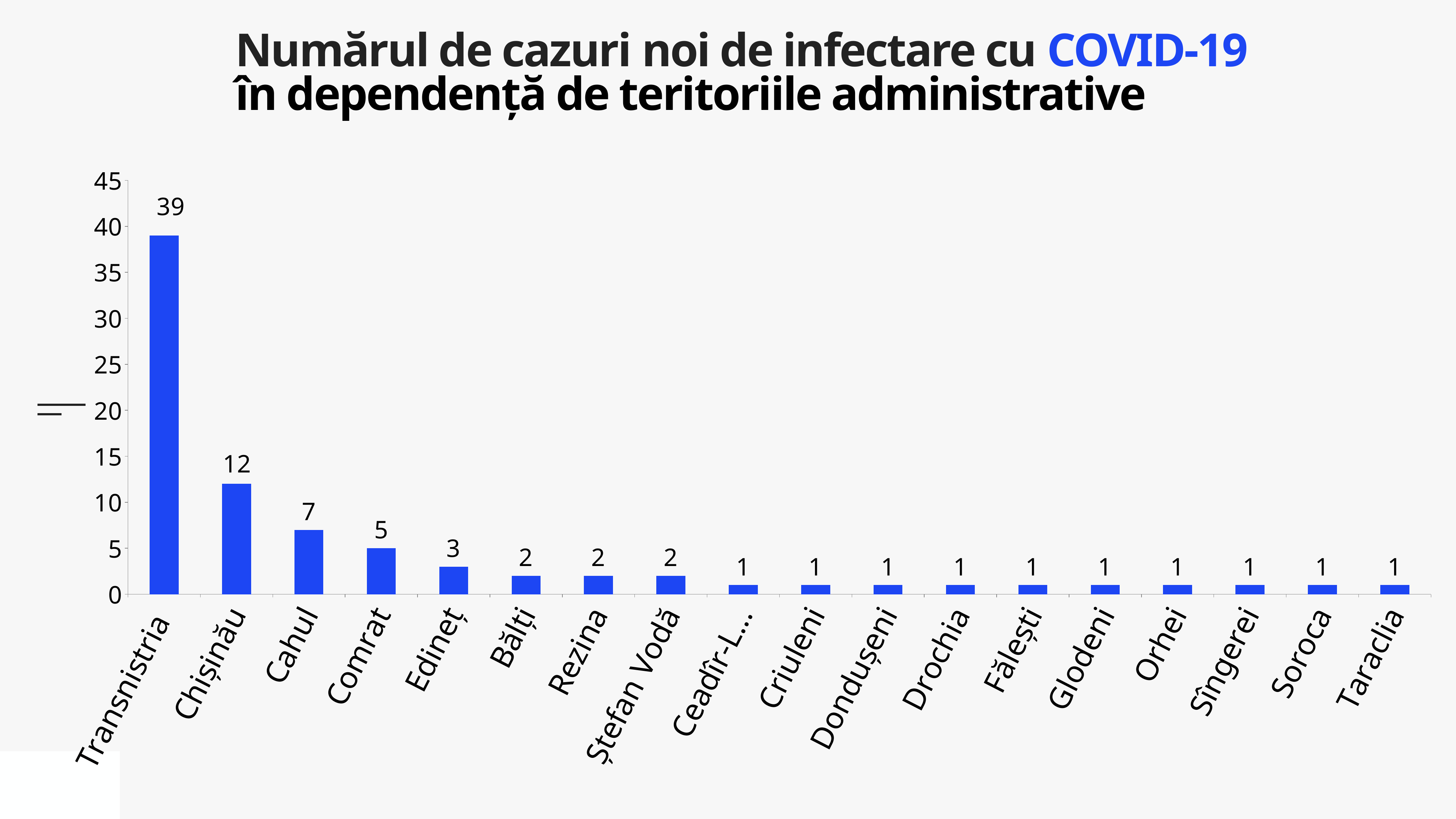
Which territory has the highest number of new cases? Transnistria Which is larger, the value for Comrat or the value for Edineț? Comrat What is the value for Transnistria? 39 What kind of chart is shown on the slide? Bar chart How many territories are shown on the x axis? 18 Do the values rise or fall from left to right along the x axis? Fall What is the value for Edineț? 3 What is the value for Cahul? 7 What is the value for Chișinău? 12 What is the difference between the values for Transnistria and Chișinău? 27 What is the difference between the values for Cahul and Comrat? 2 What is the value for Rezina? 2